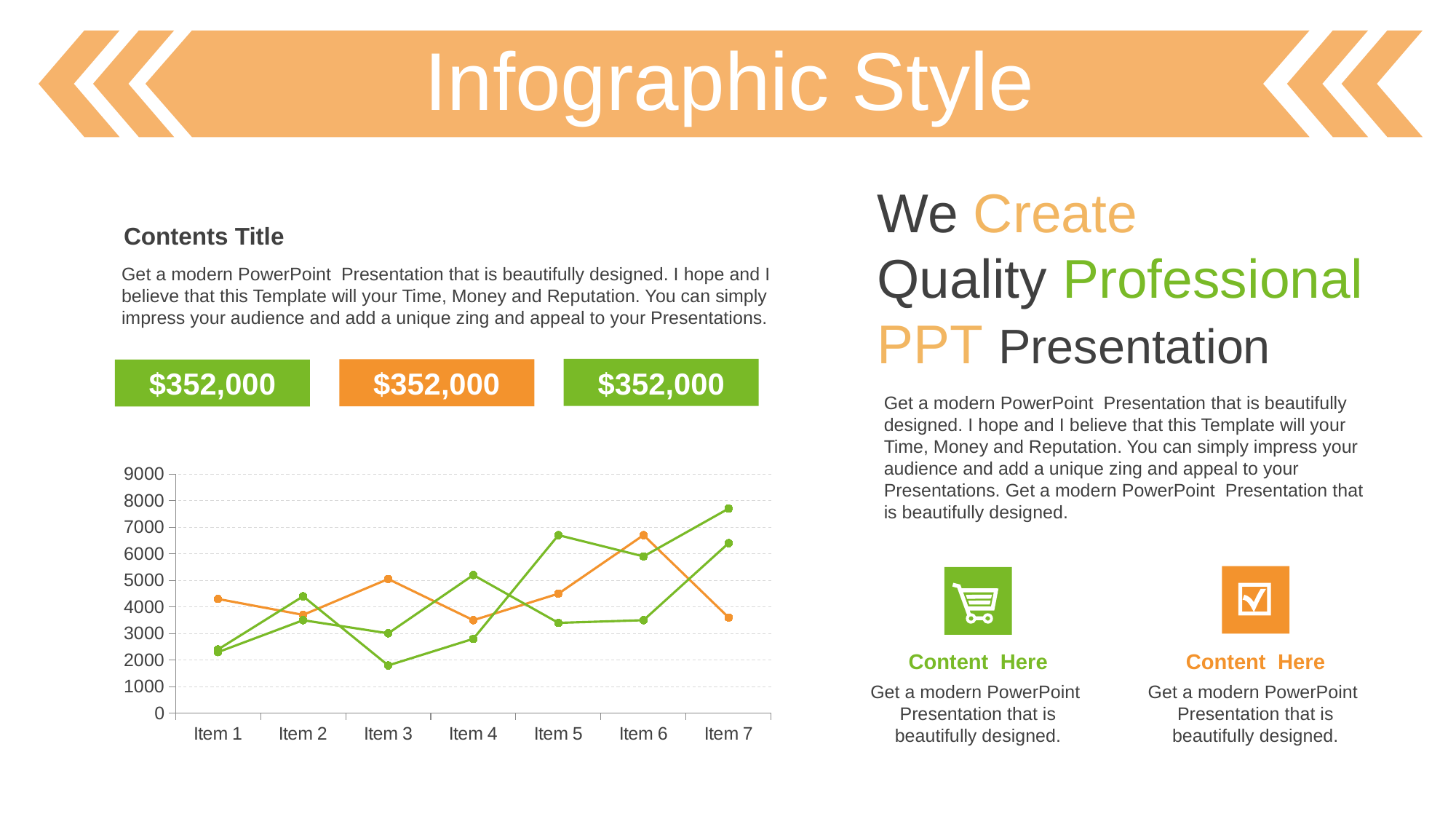
Is the value of the orange line at Item 4 greater or less than 4000? less Which is larger at Item 6: the orange line or the lower green line? the orange line Is the value of the orange line at Item 1 greater or less than 4000? greater How many lines are plotted in the line chart? 3 How many categories are shown on the x axis of the line chart? 7 What kind of chart is shown on the slide? line chart At which item does the orange line reach its highest value? Item 6 Is the highest point plotted at Item 7 greater or less than 7000? greater What colours are the lines in the chart? green and orange What is the highest value shown on the y axis of the line chart? 9000